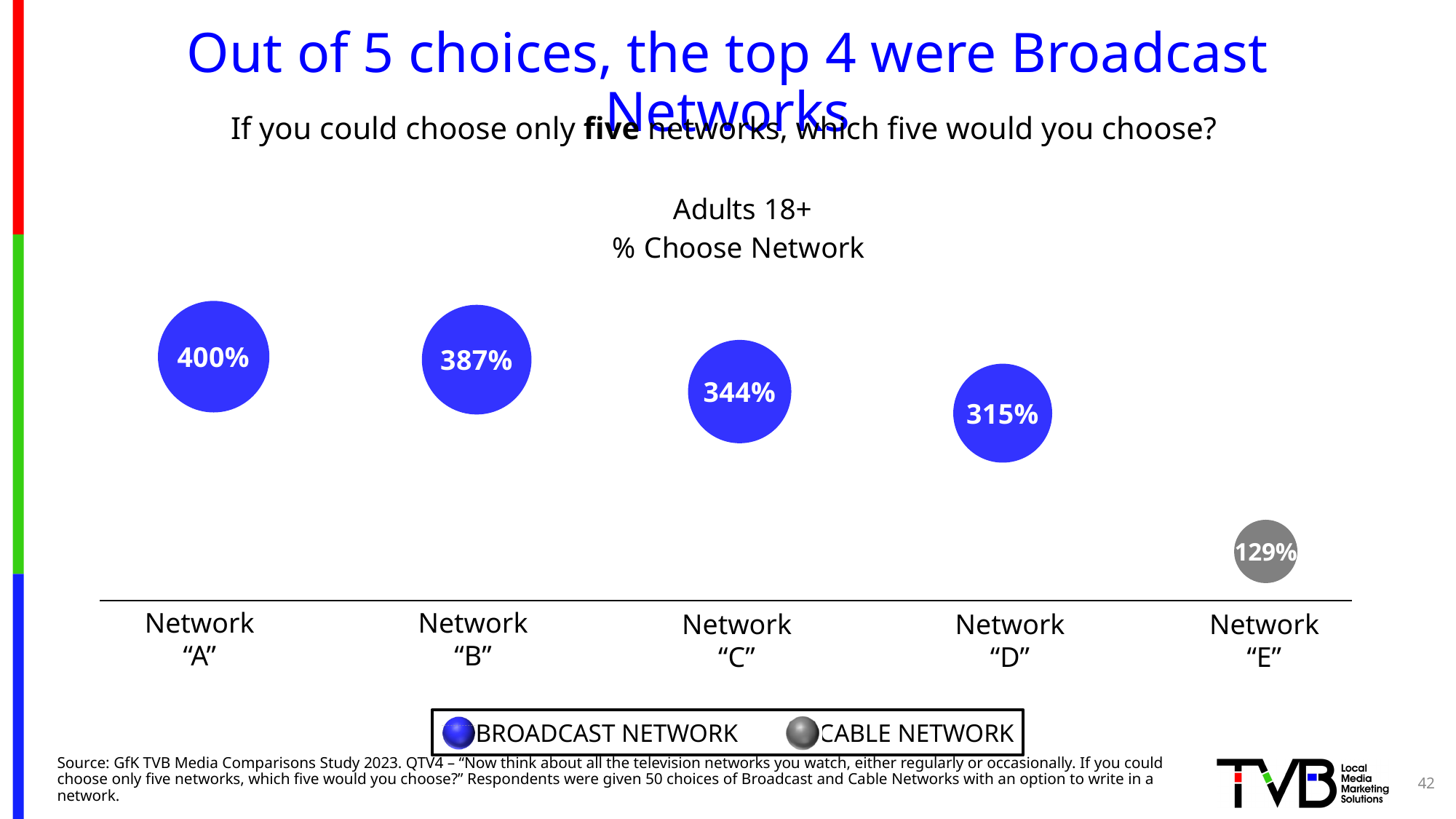
What is the value for Network "C"? 344% What is the difference between the values for Network "A" and Network "B"? 13% What is the difference between the values for Network "D" and Network "E"? 186% What is the value for Network "A"? 400% Do the values rise or fall from Network "A" to Network "E"? fall Which network has the highest value? Network "A" Which network has the lowest value? Network "E" How many networks are shown in the chart? 5 What is the value for Network "E"? 129% Which is larger, the value for Network "C" or Network "D"? Network "C" According to the legend, what does a gray bubble represent? Cable Network How many entries does the legend list? 2